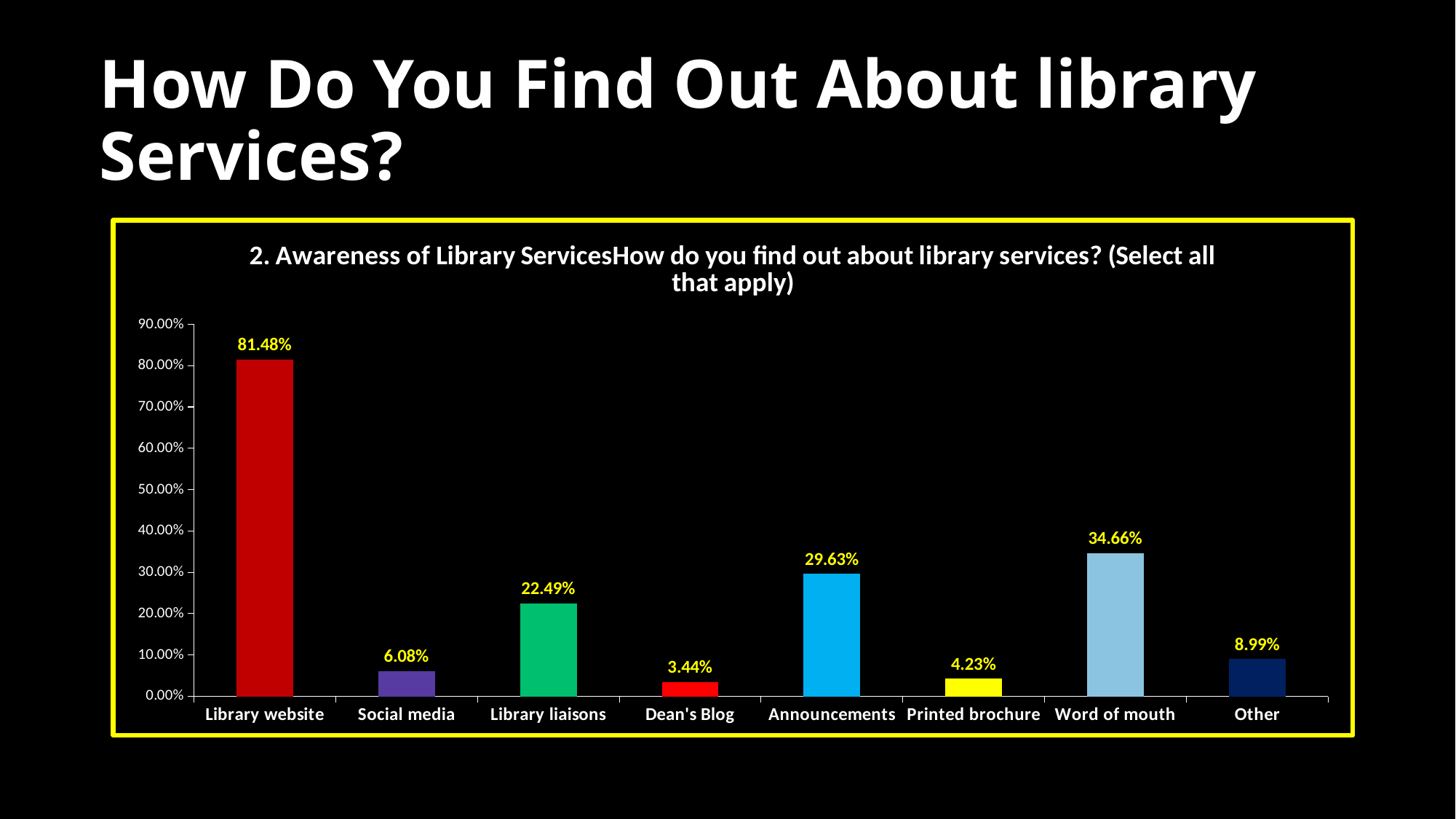
How many categories are shown on the x axis? 8 Which is larger, the value for Library liaisons or the value for Other? Library liaisons What is the value for Library website? 81.48% What kind of chart is shown on the slide? bar chart What is the difference between the values for Word of mouth and Announcements? 5.03% What is the value for Dean's Blog? 3.44% What is the difference between the values for Social media and Printed brochure? 1.85% Which category has the highest value? Library website What colour is the bar for Library website? red Which category has the lowest value? Dean's Blog What is the value for Word of mouth? 34.66% Is the value for Announcements greater or less than 20.00%? greater